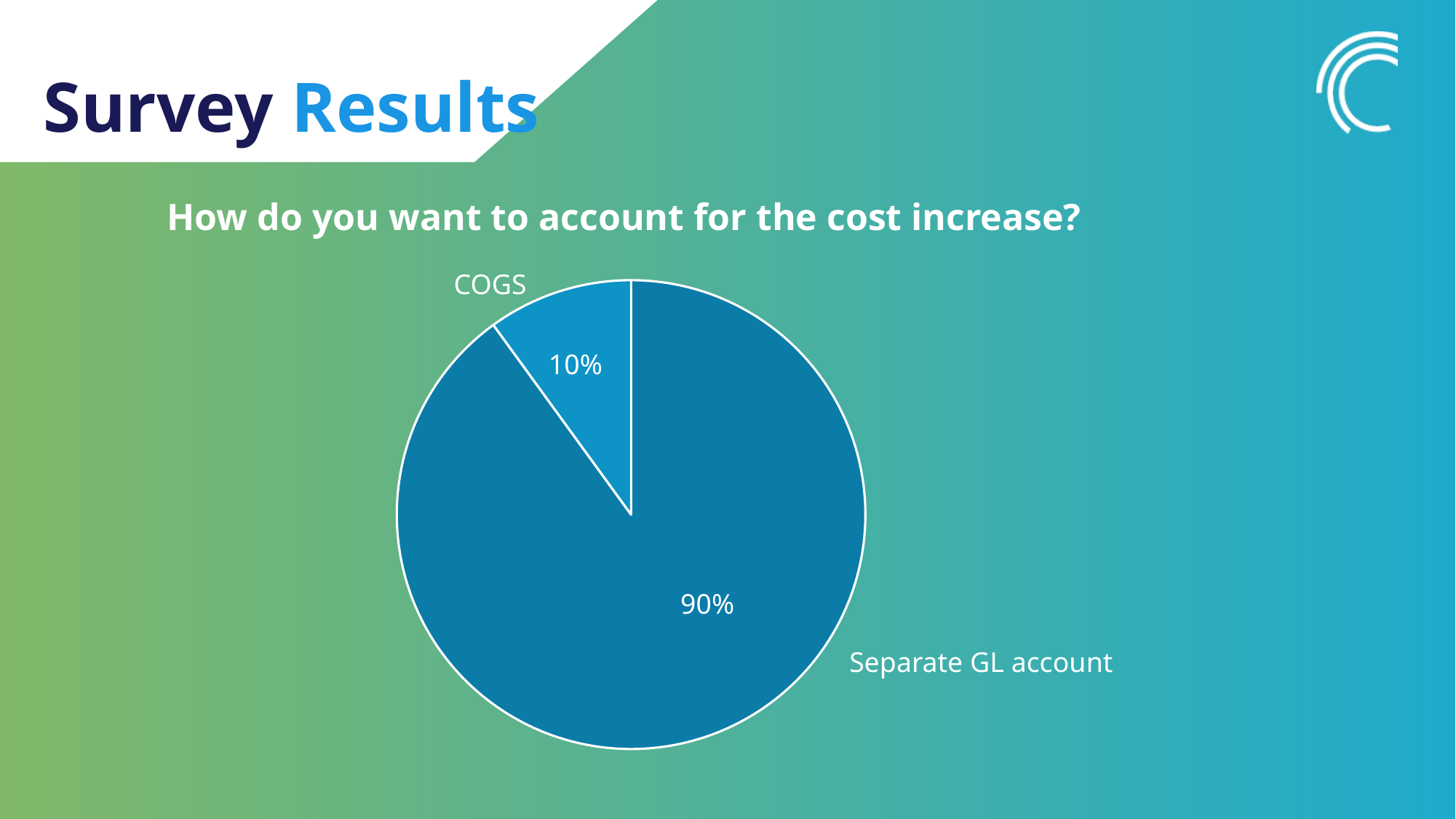
Which category has the smallest slice of the pie? COGS Which is larger, the share for COGS or the share for Separate GL account? Separate GL account What is the difference in percentage points between Separate GL account and COGS? 80 How many categories are shown in the pie chart? 2 What question does the chart title ask? How do you want to account for the cost increase? What share of the pie does Separate GL account represent? 90% What is the value labelled on the Separate GL account slice? 90% What is the value labelled on the COGS slice? 10% What share of the pie does COGS represent? 10% What kind of chart is shown on the slide? pie chart Which category has the largest slice of the pie? Separate GL account